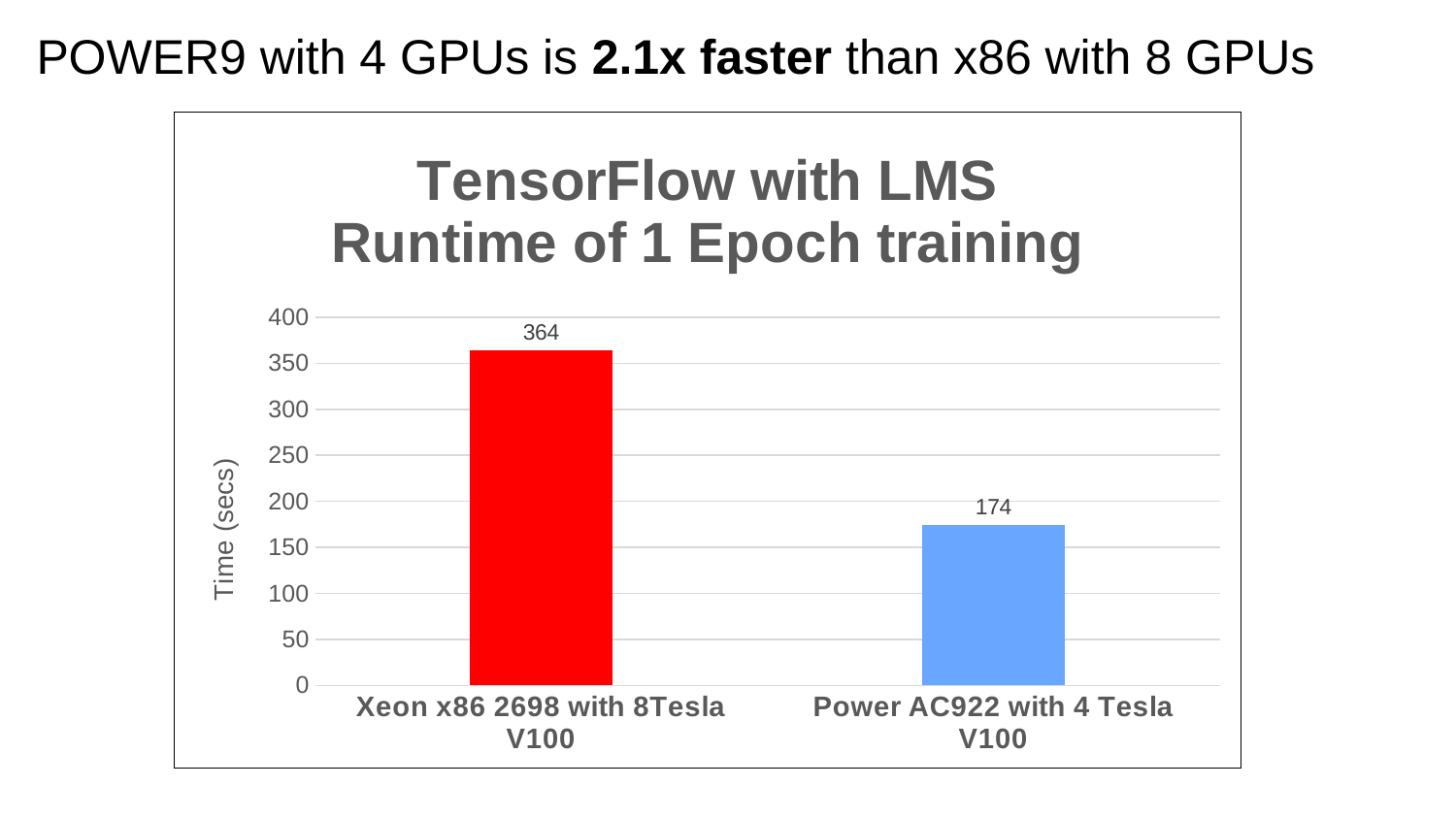
Is the value for Power AC922 with 4 Tesla V100 greater or less than 200? less What is the runtime value for Xeon x86 2698 with 8 Tesla V100? 364 Which category has the highest runtime? Xeon x86 2698 with 8Tesla V100 Which category has the lowest runtime? Power AC922 with 4 Tesla V100 What is the runtime value for Power AC922 with 4 Tesla V100? 174 How many categories are shown in the chart? 2 Which has a larger runtime, Xeon x86 2698 with 8 Tesla V100 or Power AC922 with 4 Tesla V100? Xeon x86 2698 with 8Tesla V100 What is the difference in runtime between Xeon x86 2698 with 8 Tesla V100 and Power AC922 with 4 Tesla V100? 190 Is the value for Xeon x86 2698 with 8 Tesla V100 greater or less than 350? greater What kind of chart is shown on the slide? bar chart What is the label of the vertical axis? Time (secs) What is the title of the chart? TensorFlow with LMS Runtime of 1 Epoch training